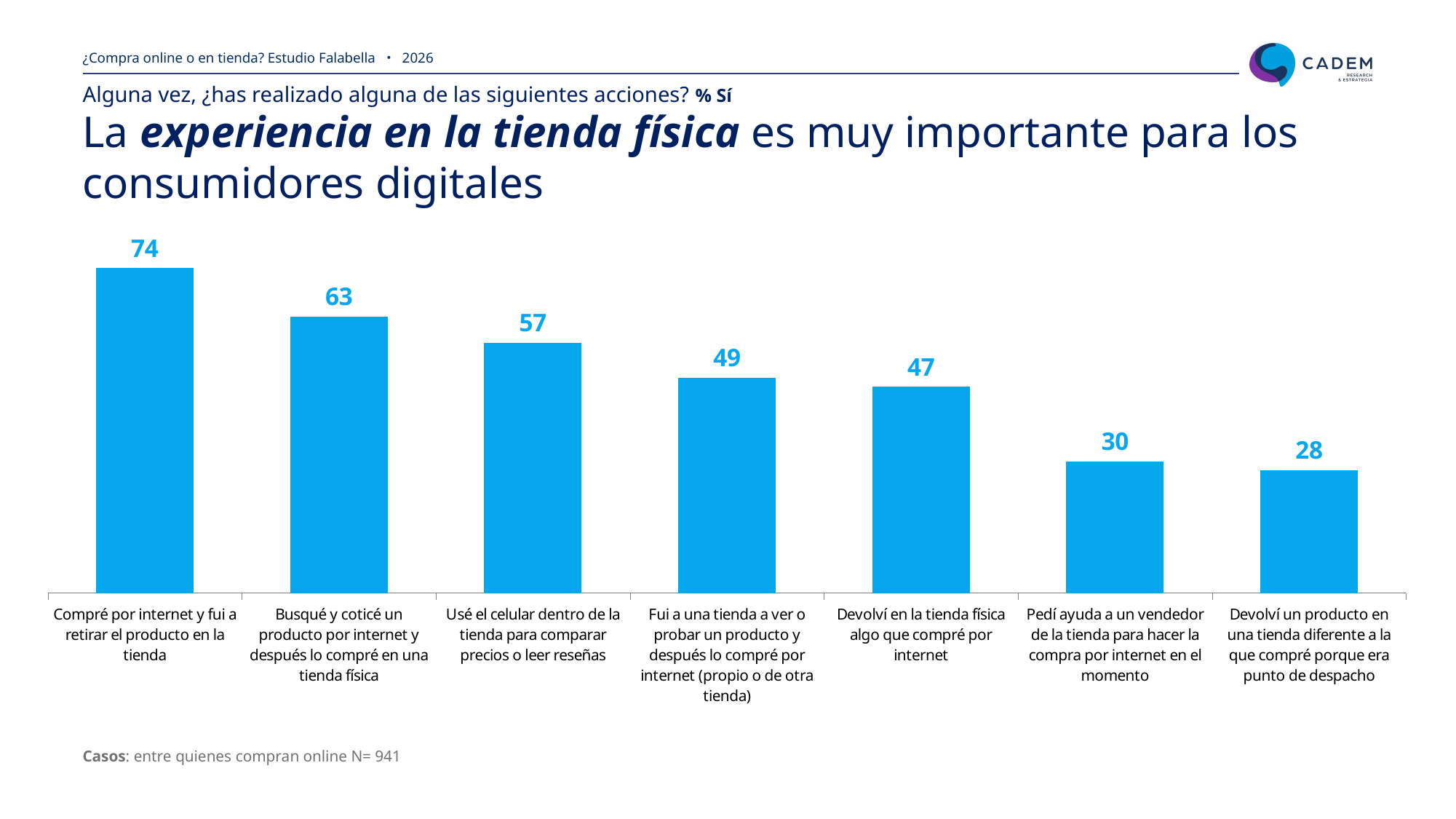
What kind of chart is shown on the slide? Bar chart What is the difference between the value for "Compré por internet y fui a retirar el producto en la tienda" and the value for "Busqué y coticé un producto por internet y después lo compré en una tienda física"? 11 Do the values rise or fall from left to right across the chart? Fall How many actions (categories) are shown in the chart? 7 Which action has the lowest percentage of "Sí" responses? Devolví un producto en una tienda diferente a la que compré porque era punto de despacho Which is larger: the value for "Fui a una tienda a ver o probar un producto y después lo compré por internet" or the value for "Devolví en la tienda física algo que compré por internet"? Fui a una tienda a ver o probar un producto y después lo compré por internet What is the difference between the value for "Pedí ayuda a un vendedor de la tienda para hacer la compra por internet en el momento" and the value for "Devolví un producto en una tienda diferente a la que compré porque era punto de despacho"? 2 Which action has the highest percentage of "Sí" responses? Compré por internet y fui a retirar el producto en la tienda What is the value for "Usé el celular dentro de la tienda para comparar precios o leer reseñas"? 57 What is the sample size (N) stated at the bottom of the slide? 941 What percentage of respondents said they bought online and picked up the product in the store ("Compré por internet y fui a retirar el producto en la tienda")? 74 What is the value for "Devolví en la tienda física algo que compré por internet"? 47